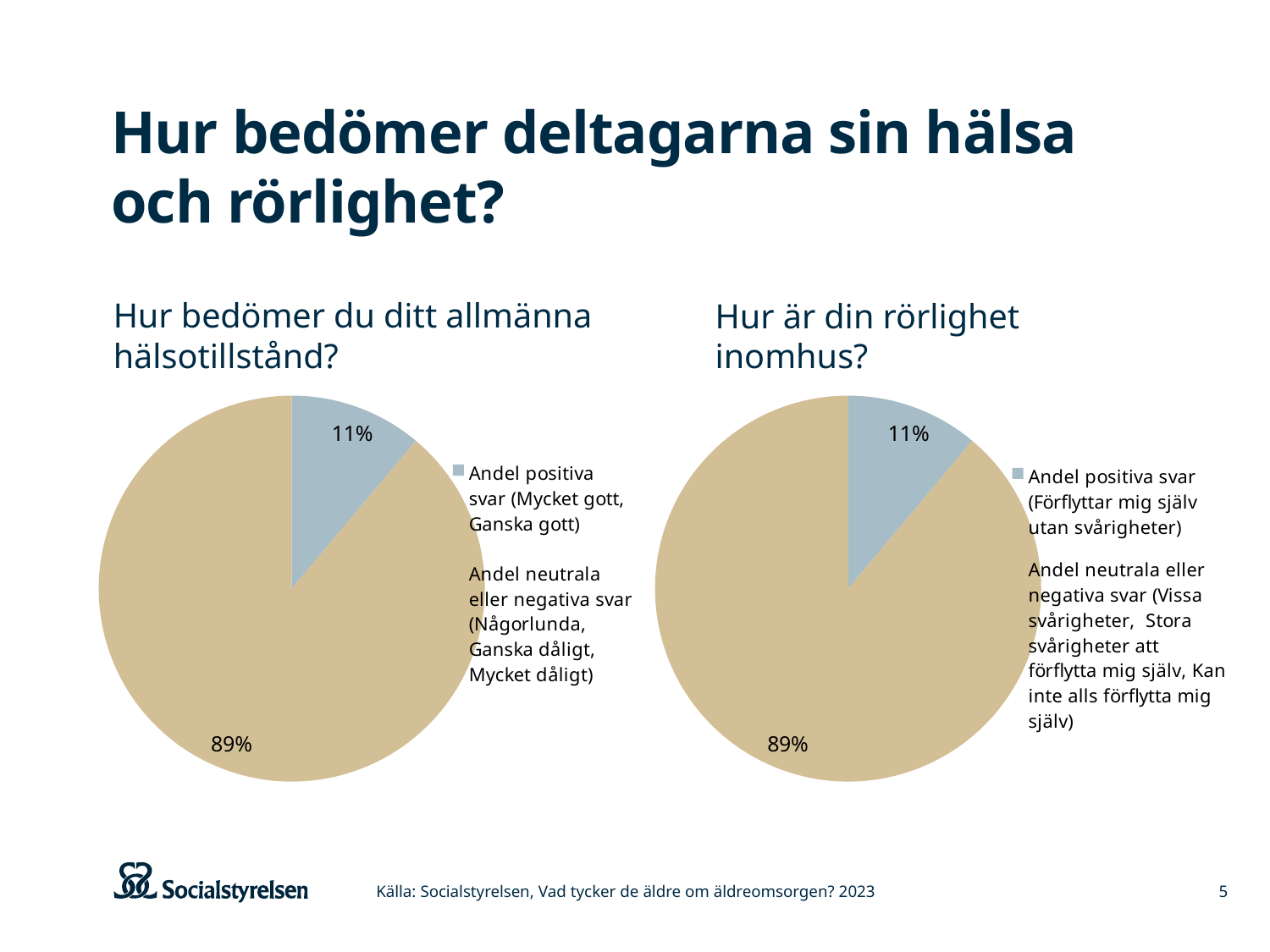
In the right chart titled "Hur är din rörlighet inomhus?", which is larger: the share of positive answers or the share of neutral or negative answers? Andel neutrala eller negativa svar In the right chart titled "Hur är din rörlighet inomhus?", what colour is the slice for "Andel positiva svar"? Blue-grey In the right chart titled "Hur är din rörlighet inomhus?", what share is labelled for the slice "Andel neutrala eller negativa svar"? 89% In the right chart titled "Hur är din rörlighet inomhus?", what share is labelled for the slice "Andel positiva svar (Förflyttar mig själv utan svårigheter)"? 11% In the left chart titled "Hur bedömer du ditt allmänna hälsotillstånd?", what is the difference in percentage points between the 89% slice and the 11% slice? 78 percentage points In the left chart titled "Hur bedömer du ditt allmänna hälsotillstånd?", which slice is the largest? Andel neutrala eller negativa svar What kind of chart is used on the left of the slide, titled "Hur bedömer du ditt allmänna hälsotillstånd?"? Pie chart How many entries does the legend of the left chart titled "Hur bedömer du ditt allmänna hälsotillstånd?" list? 2 In the right chart titled "Hur är din rörlighet inomhus?", which slice is the smallest? Andel positiva svar In the left chart titled "Hur bedömer du ditt allmänna hälsotillstånd?", what share is labelled for the slice "Andel positiva svar (Mycket gott, Ganska gott)"? 11% In the left chart titled "Hur bedömer du ditt allmänna hälsotillstånd?", what share is labelled for the slice "Andel neutrala eller negativa svar"? 89% How many slices does the right chart titled "Hur är din rörlighet inomhus?" have? 2